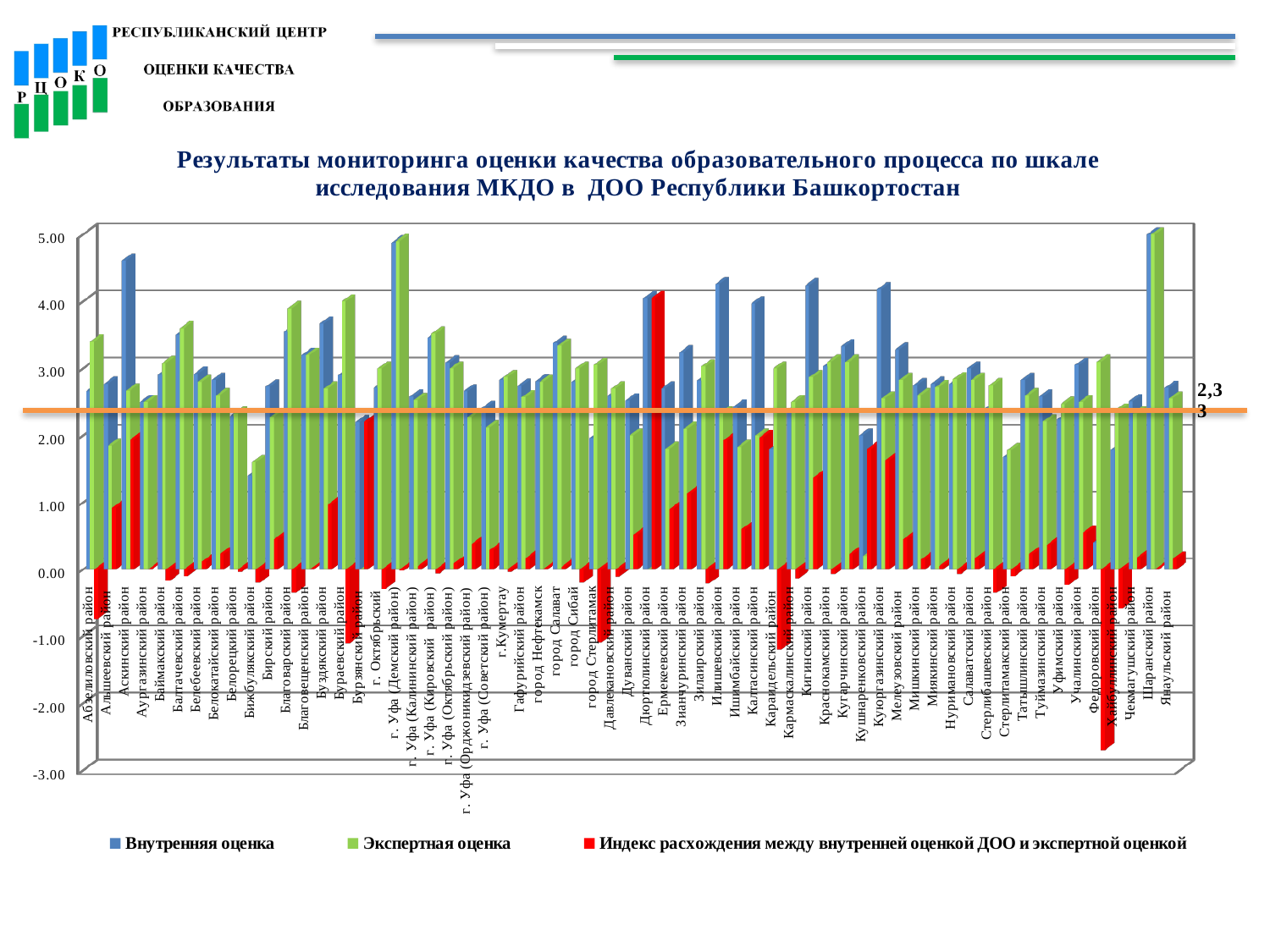
Is the Внутренняя оценка value for Стерлитамакский район greater or less than 2.00? less Is the Экспертная оценка value for Бижбулякский район greater or less than 2.00? less What kind of chart is shown on the slide? bar chart How many series does the chart legend list? 3 For Дюртюлинский район, which is larger: the Внутренняя оценка or the Экспертная оценка? Внутренняя оценка Is the Внутренняя оценка value for Илишевский район greater or less than 4.00? greater What value is marked by the horizontal orange line across the chart? 2,33 Which category has the lowest value for Индекс расхождения между внутренней оценкой ДОО и экспертной оценкой? Федоровский район Which category has the highest value for Индекс расхождения между внутренней оценкой ДОО и экспертной оценкой? Дюртюлинский район Which series is shown in red in the chart? Индекс расхождения между внутренней оценкой ДОО и экспертной оценкой